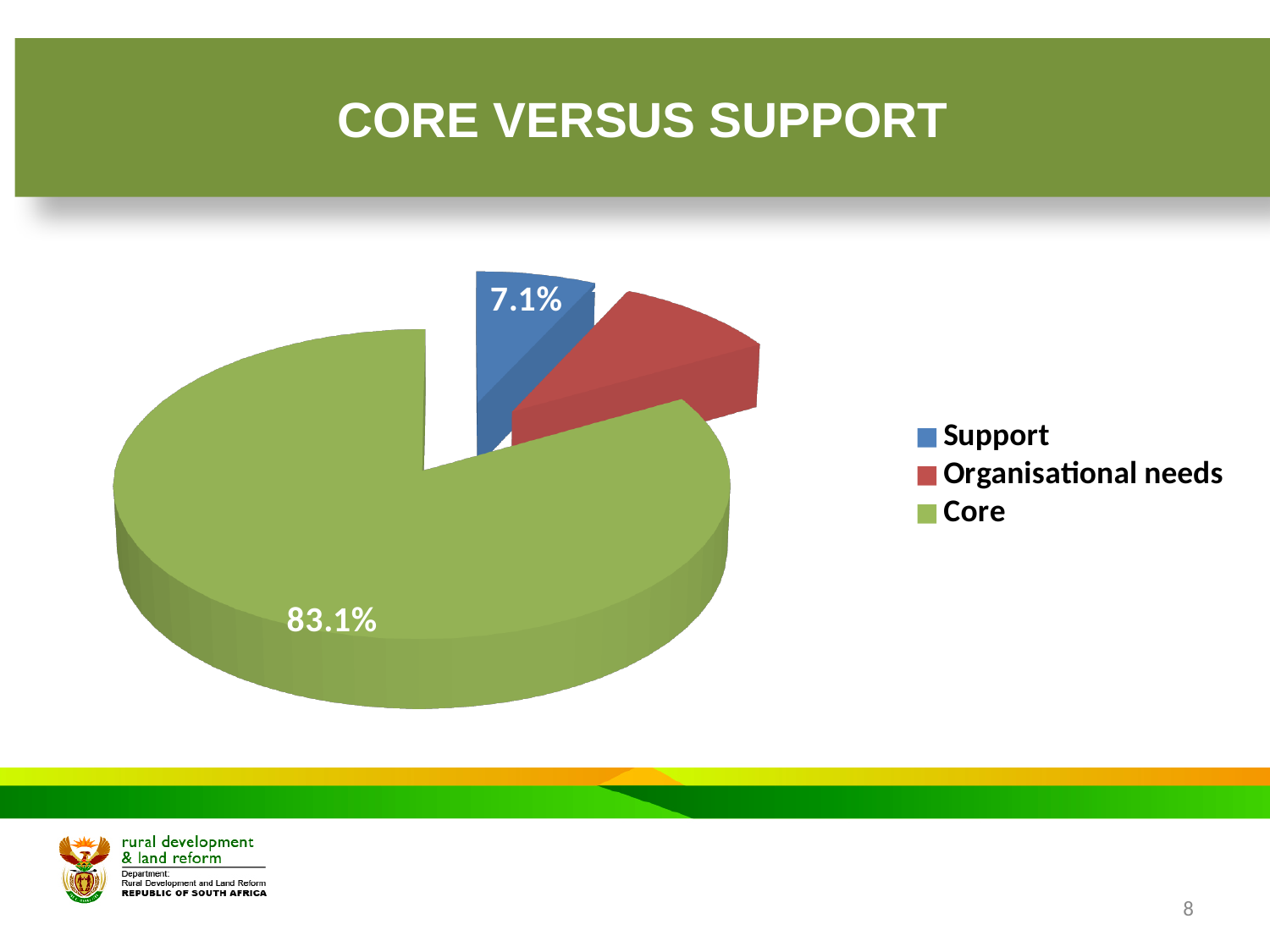
Which category has the largest slice of the pie? Core How many categories are shown in the pie chart? 3 What is the difference between the Core and Support percentages? 76.0% What is the title of the slide containing the chart? CORE VERSUS SUPPORT Which category has the smallest slice of the pie? Support What kind of chart is shown on the slide? pie chart Which is larger, the Organisational needs slice or the Support slice? Organisational needs What colour is the Core slice in the pie chart? green How many entries does the legend list? 3 Which is larger, the Core slice or the Support slice? Core What percentage does the Core slice represent? 83.1% What percentage does the Support slice represent? 7.1%